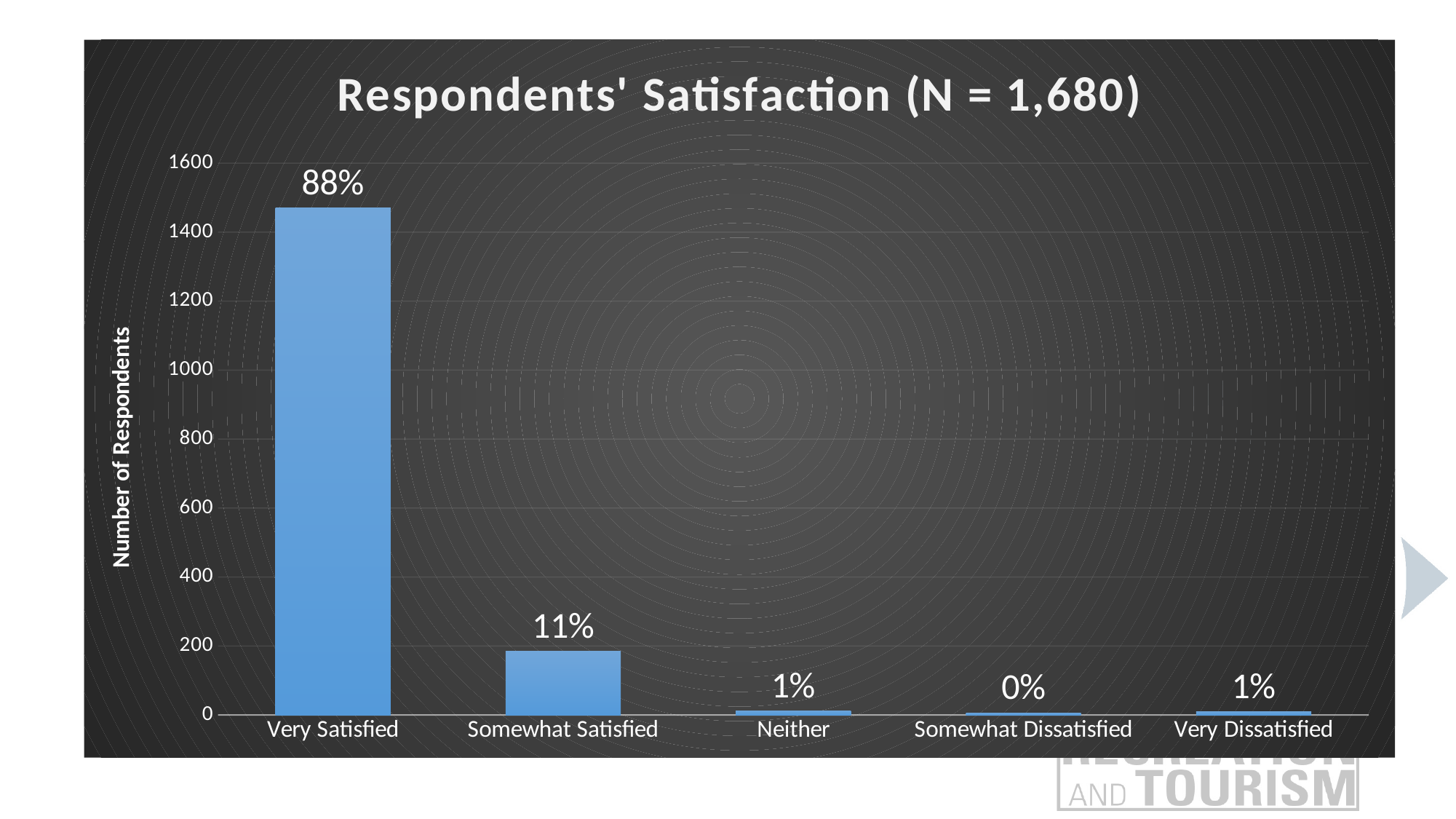
Which category has the lowest number of respondents? Somewhat Dissatisfied What percentage label is shown above the Very Dissatisfied bar? 1% Is the number of respondents for Somewhat Satisfied greater or less than 400? less What kind of chart is shown on the slide? Bar chart What percentage label is shown above the Somewhat Dissatisfied bar? 0% What percentage label is shown above the Somewhat Satisfied bar? 11% Which has more respondents, Somewhat Satisfied or Neither? Somewhat Satisfied By how many percentage points does the Very Satisfied label exceed the Somewhat Satisfied label? 77 percentage points Is the number of respondents for Very Satisfied greater or less than 1400? greater What percentage label is shown above the Very Satisfied bar? 88% How many satisfaction categories are shown on the x axis? 5 Which category has the highest number of respondents? Very Satisfied